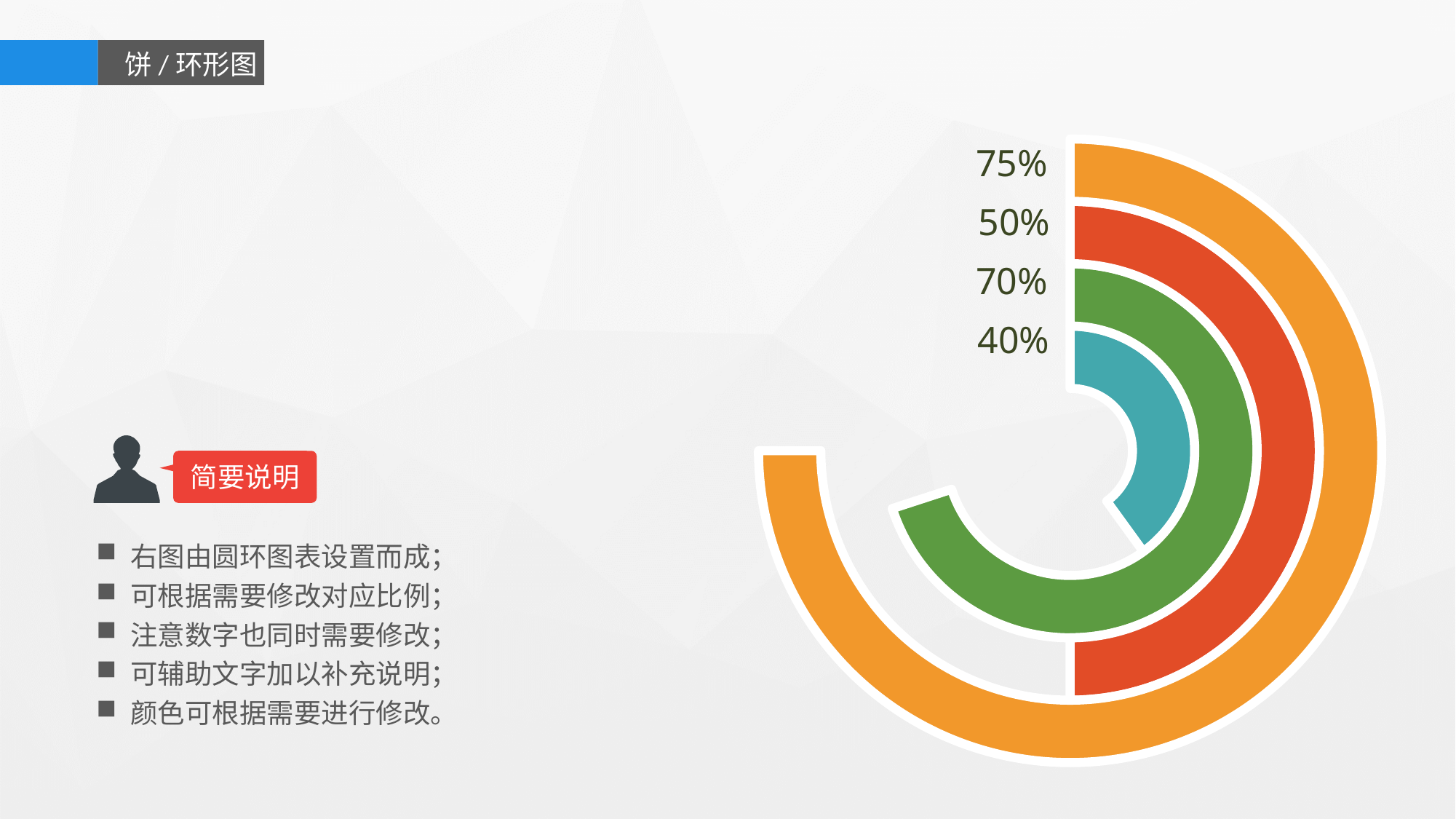
Which ring has the lowest percentage? the blue ring (40%) Which is larger, the value of the green ring or the value of the red ring? the green ring How many rings (series) does the doughnut chart show? 4 What is the title shown in the header box at the top left of the slide? 饼 / 环形图 What percentage is shown for the outermost orange ring? 75% What percentage is shown for the red ring? 50% What is the difference between the green ring's value and the red ring's value? 20% What kind of chart is shown on the right of the slide? doughnut chart What percentage is shown for the innermost blue ring? 40% What is the difference between the orange ring's value and the blue ring's value? 35% Which ring has the highest percentage? the orange ring (75%) What percentage is shown for the green ring? 70%